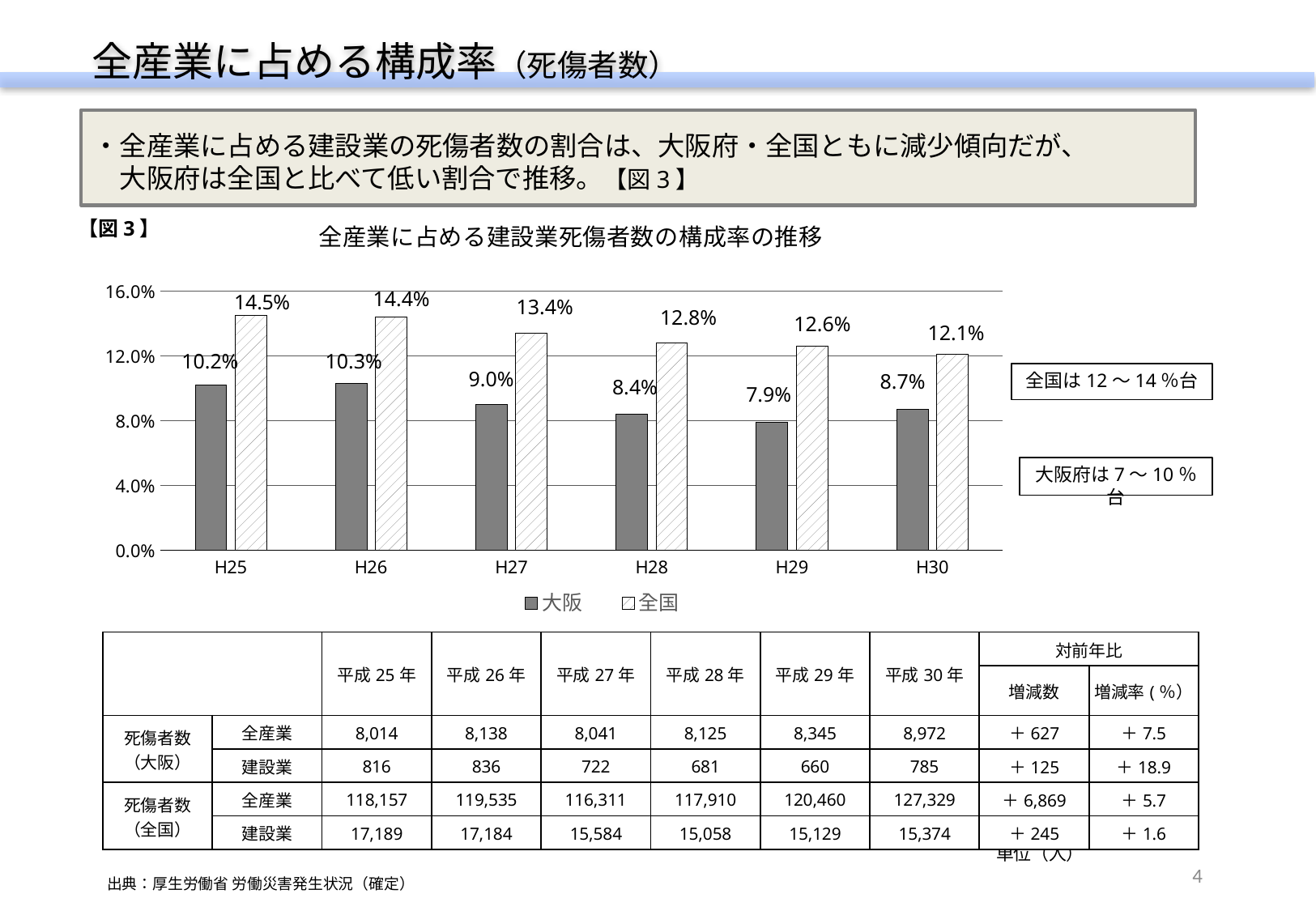
In which year is the 大阪 value lowest? H29 What is the value for 大阪 in H29? 7.9% How many years are shown on the x axis of the chart? 6 How many series does the chart legend list? 2 Which is larger in H28, the 大阪 value or the 全国 value? 全国 What is the difference between the 全国 and 大阪 values in H25? 4.3% Is the value for 大阪 in H26 greater or less than 8.0%? greater What is the value for 全国 in H30? 12.1% What is the value for 大阪 in H27? 9.0% What type of chart is shown in 【図3】? bar chart Does the 全国 value rise or fall from H25 to H30? fall In which year is the 全国 value highest? H25